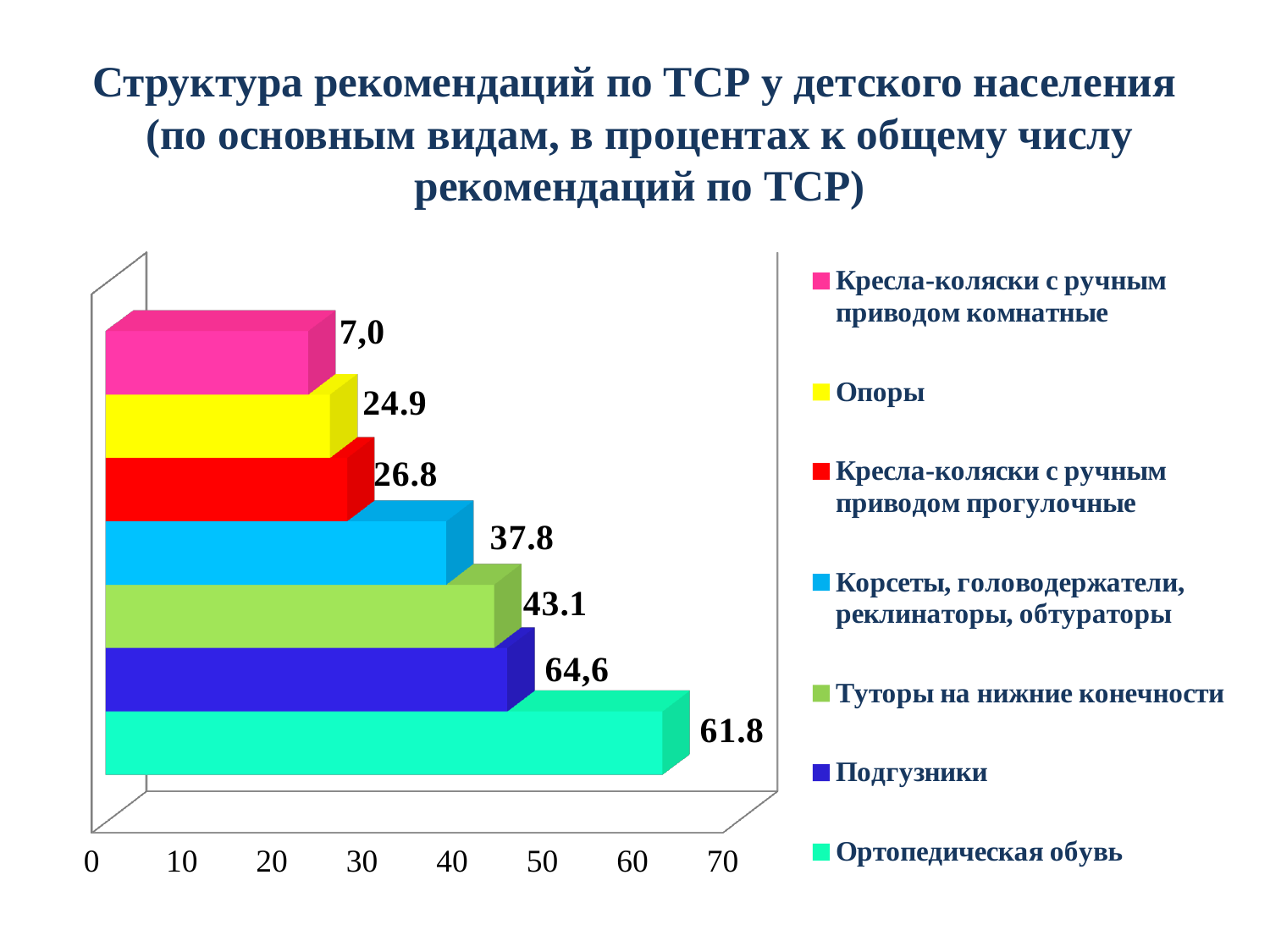
What value is shown for Кресла-коляски с ручным приводом комнатные? 7,0 What is the difference between the values for Кресла-коляски с ручным приводом прогулочные and Опоры? 1.9 How many bars does the chart show? 7 What value is shown for Корсеты, головодержатели, реклинаторы, обтураторы? 37.8 What value is shown for Ортопедическая обувь? 61.8 What kind of chart is shown on the slide? bar chart What is the difference between the values for Туторы на нижние конечности and Корсеты, головодержатели, реклинаторы, обтураторы? 5.3 How many entries does the legend list? 7 What value is shown for Туторы на нижние конечности? 43.1 Which is larger, the value for Туторы на нижние конечности or the value for Корсеты, головодержатели, реклинаторы, обтураторы? Туторы на нижние конечности Which category has the lowest value? Кресла-коляски с ручным приводом комнатные What value is shown for Опоры? 24.9